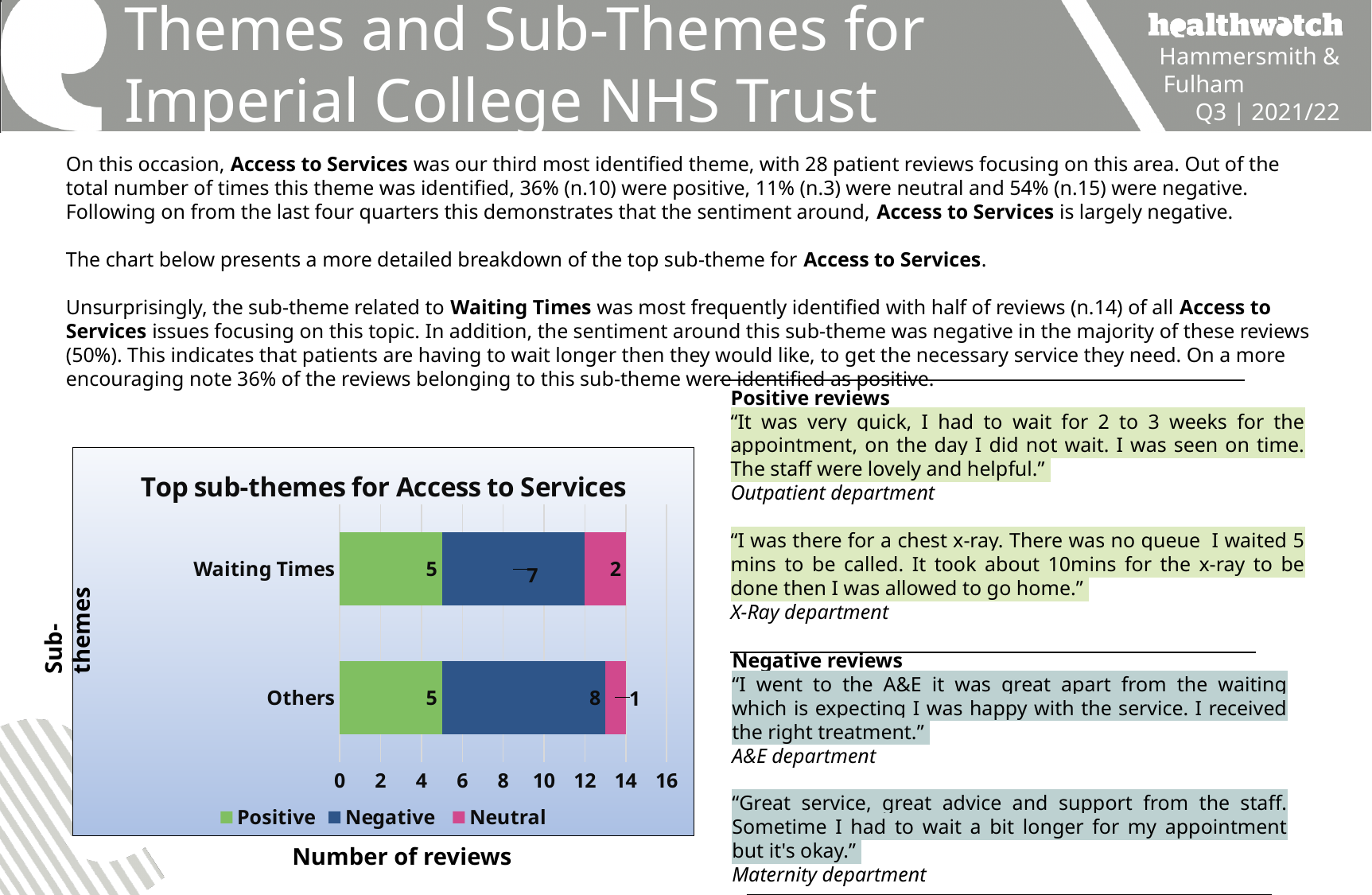
What is the Neutral value for Waiting Times? 2 What is the Negative value for Others? 8 What is the title of the chart? Top sub-themes for Access to Services What is the Positive value for Others? 5 What is the label of the x axis? Number of reviews How many series does the chart legend list? 3 Which sub-theme has the higher Neutral value, Waiting Times or Others? Waiting Times What is the difference between the Negative values for Others and Waiting Times? 1 What is the total number of reviews for the Waiting Times bar? 14 How many sub-theme categories are plotted in the chart? 2 What is the Negative value for Waiting Times? 7 What type of chart is shown on the slide? Stacked bar chart